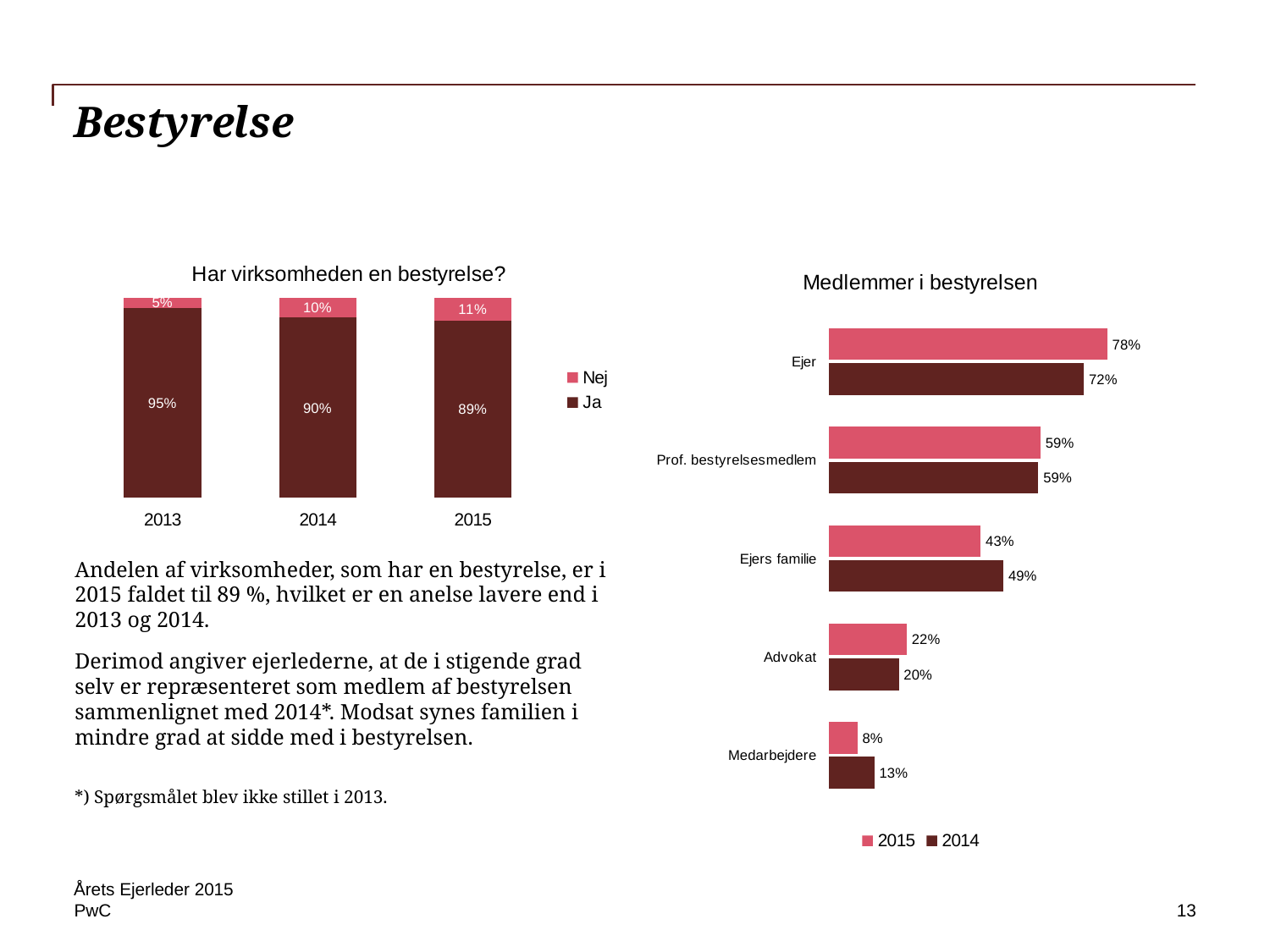
In the chart 'Har virksomheden en bestyrelse?', does the 'Ja' share rise or fall from 2013 to 2015? fall In the chart 'Har virksomheden en bestyrelse?', what is the 'Nej' value for 2013? 5% In the chart 'Medlemmer i bestyrelsen', what is the 2014 value for Medarbejdere? 13% What kind of chart is 'Medlemmer i bestyrelsen'? bar chart In the chart 'Medlemmer i bestyrelsen', which is larger for Advokat: the 2015 value or the 2014 value? 2015 In the chart 'Har virksomheden en bestyrelse?', how many series does the legend list? 2 In the chart 'Medlemmer i bestyrelsen', what is the 2015 value for Ejer? 78% In the chart 'Har virksomheden en bestyrelse?', what is the 'Ja' value for 2015? 89% In the chart 'Medlemmer i bestyrelsen', how many categories are shown? 5 In the chart 'Medlemmer i bestyrelsen', which category has the lowest 2015 value? Medarbejdere In the chart 'Medlemmer i bestyrelsen', what is the difference between the 2014 and 2015 values for Ejers familie? 6% In the chart 'Har virksomheden en bestyrelse?', which year has the highest 'Ja' share? 2013